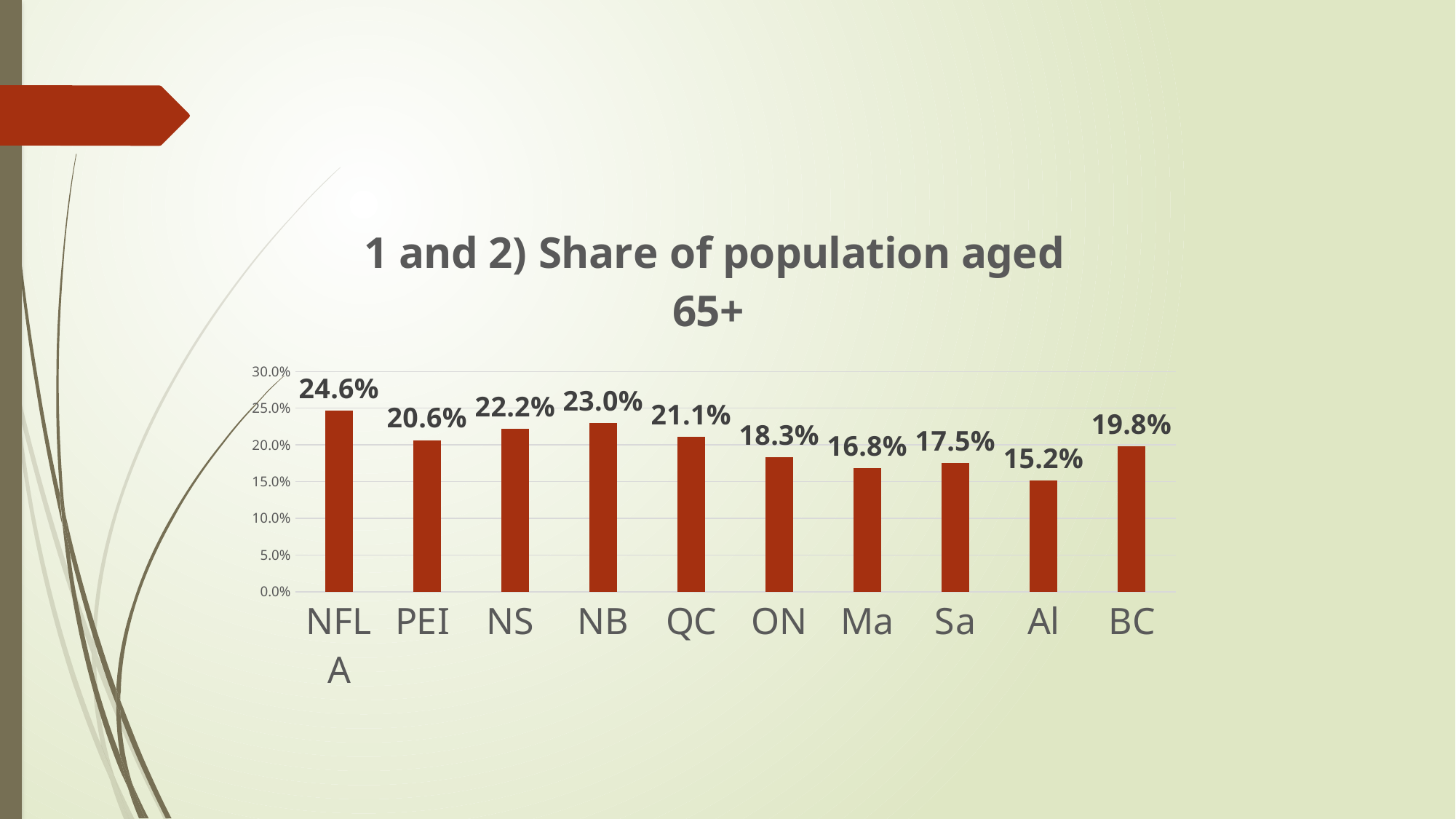
What kind of chart is shown on the slide? bar chart Which province has the lowest share of population aged 65+? Al Which has a larger share of population aged 65+, NS or PEI? NS What is the share of population aged 65+ for QC? 21.1% What is the share of population aged 65+ for BC? 19.8% What is the share of population aged 65+ for NFLA? 24.6% Which province has the highest share of population aged 65+? NFLA Is the value for Ma greater or less than 20.0%? less What is the difference between the share for Sa and the share for Al? 2.3% How many provinces are shown on the chart? 10 What is the title of the chart? 1 and 2) Share of population aged 65+ What is the difference between the share for NB and the share for ON? 4.7%